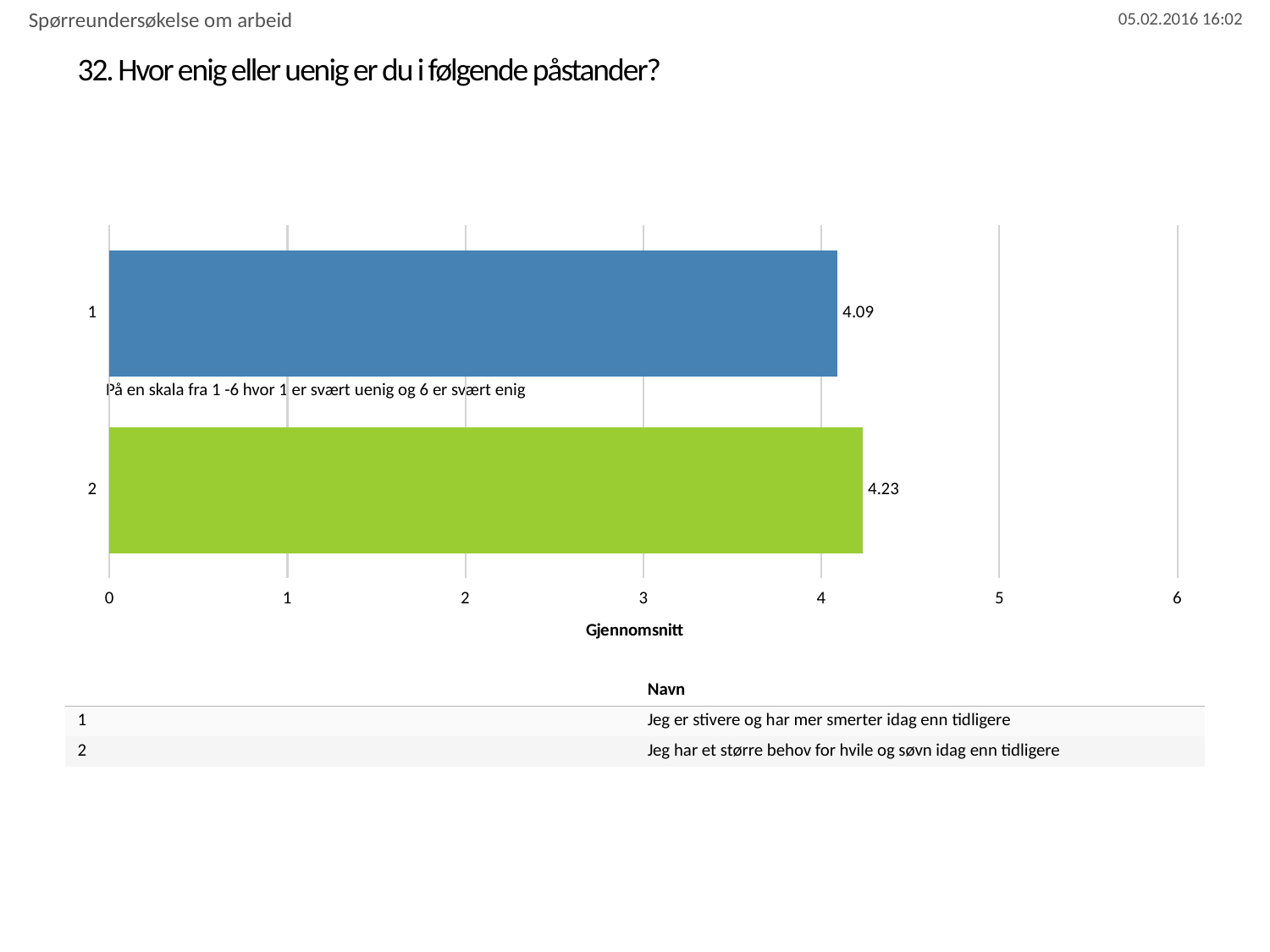
What is the value for category 2? 4.23 What kind of chart is shown? bar chart Is the value for category 1 greater or less than 4? greater Which is larger, the value for category 1 or category 2? 2 Is the value for category 2 greater or less than 5? less What is the difference between the values for category 2 and category 1? 0.14 Which category has the lowest value? 1 Which category has the highest value? 2 What is the maximum value shown on the x axis? 6 What is the value for category 1? 4.09 How many categories are shown in the chart? 2 What is the label of the x axis? Gjennomsnitt